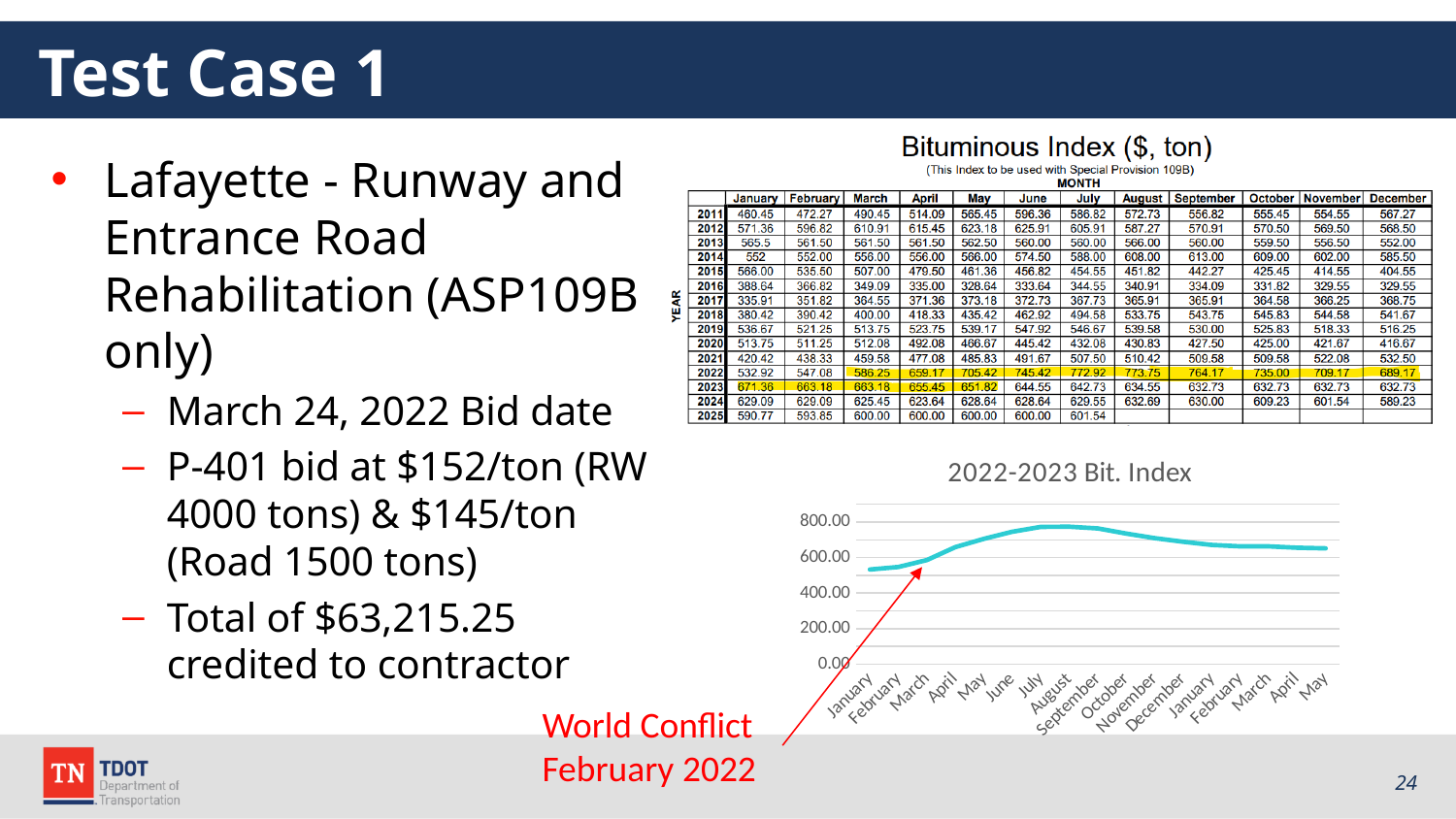
In the "2022-2023 Bit. Index" chart, do the values rise or fall from January to August? rise In the "2022-2023 Bit. Index" chart, is the value for August greater or less than 600.00? greater How many month points are plotted along the x axis of the "2022-2023 Bit. Index" chart? 17 What is the title of the chart at the bottom right of the slide? 2022-2023 Bit. Index In the "2022-2023 Bit. Index" chart, do the values rise or fall from September to December? fall Which month has the lowest value in the "2022-2023 Bit. Index" chart? January (the first one) In the "2022-2023 Bit. Index" chart, is the highest point of the line greater or less than 800.00? less In the "2022-2023 Bit. Index" chart, is the value for the final May greater or less than 600.00? greater What is the highest value shown on the y axis of the "2022-2023 Bit. Index" chart? 800.00 What kind of chart is the "2022-2023 Bit. Index" chart? line chart